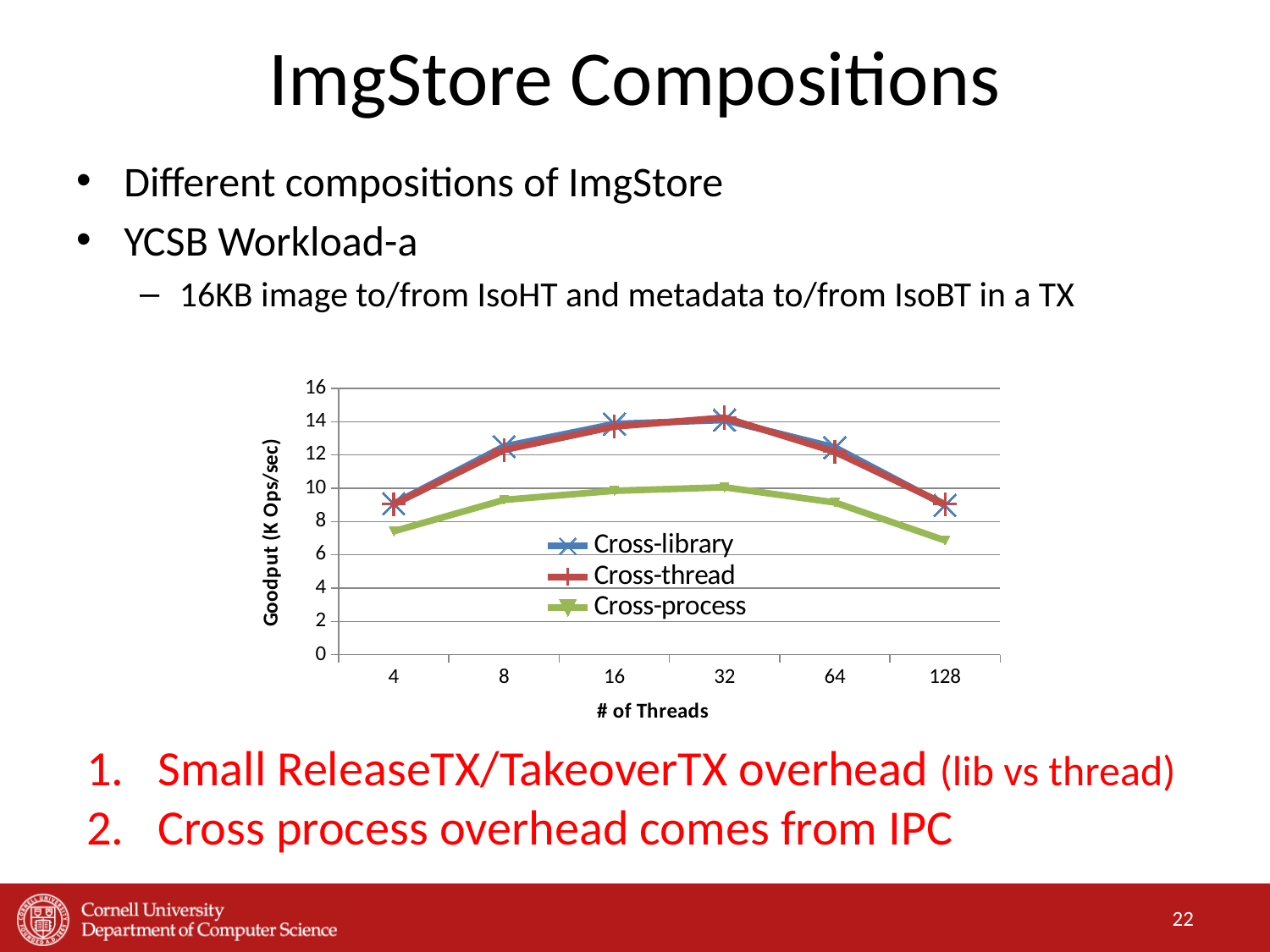
At 64 threads, which has the higher goodput, Cross-library or Cross-process? Cross-library What kind of chart is shown on the slide? line chart How many thread counts are plotted along the x axis? 6 At which number of threads does the Cross-process series reach its lowest goodput? 128 Is the goodput for Cross-library at 16 threads greater or less than 12? greater How many series does the chart legend list? 3 What is the title of the y axis? Goodput (K Ops/sec) Which series has the lowest goodput at 32 threads? Cross-process Is the goodput for Cross-process at 4 threads greater or less than 8? less Does the Cross-process goodput rise or fall from 32 threads to 128 threads? fall What is the title of the x axis? # of Threads Is the goodput for Cross-thread at 128 threads greater or less than 10? less